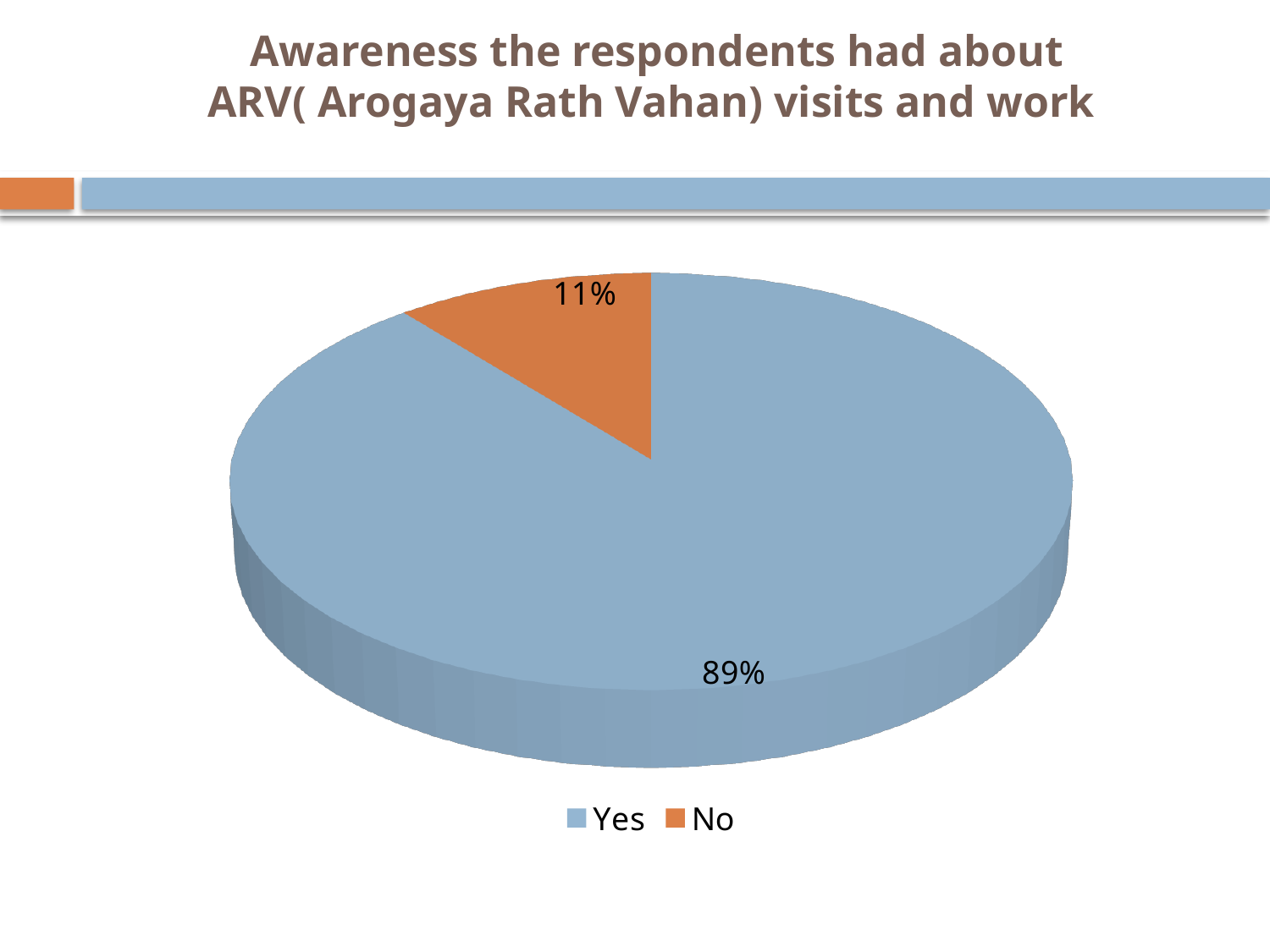
What is the difference in percentage points between the Yes and No slices? 78 What kind of chart is shown on the slide? pie chart How many slices does the pie chart have? 2 What percentage of respondents answered No? 11% What percentage of respondents answered Yes? 89% What is the title of the chart? Awareness the respondents had about ARV( Arogaya Rath Vahan) visits and work Which response has the largest share of the pie? Yes Which slice is larger, Yes or No? Yes Which response has the smallest share of the pie? No What share of the pie does the No slice represent? 11% How many entries does the legend list? 2 What colour is the Yes slice? blue